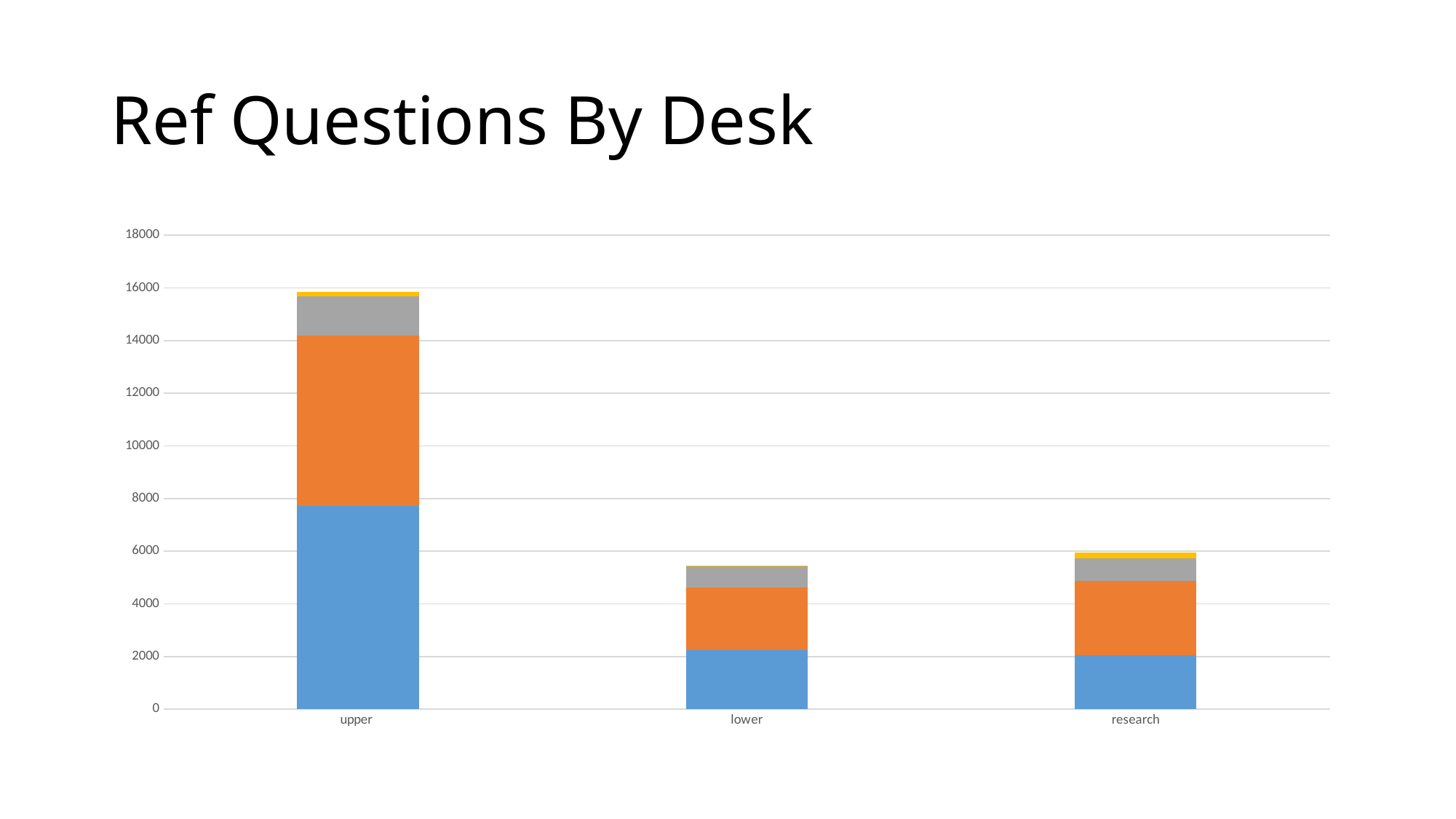
Which category has the tallest stacked bar? upper What kind of chart is shown on the slide? stacked bar chart Is the blue segment for upper greater or less than 6000? greater Is the total for upper greater or less than 14000? greater Which has the larger total, upper or lower? upper How many categories are shown on the x axis? 3 Is the total for research greater or less than 4000? greater How many coloured segments make up the upper bar? 4 What is the title of the slide? Ref Questions By Desk